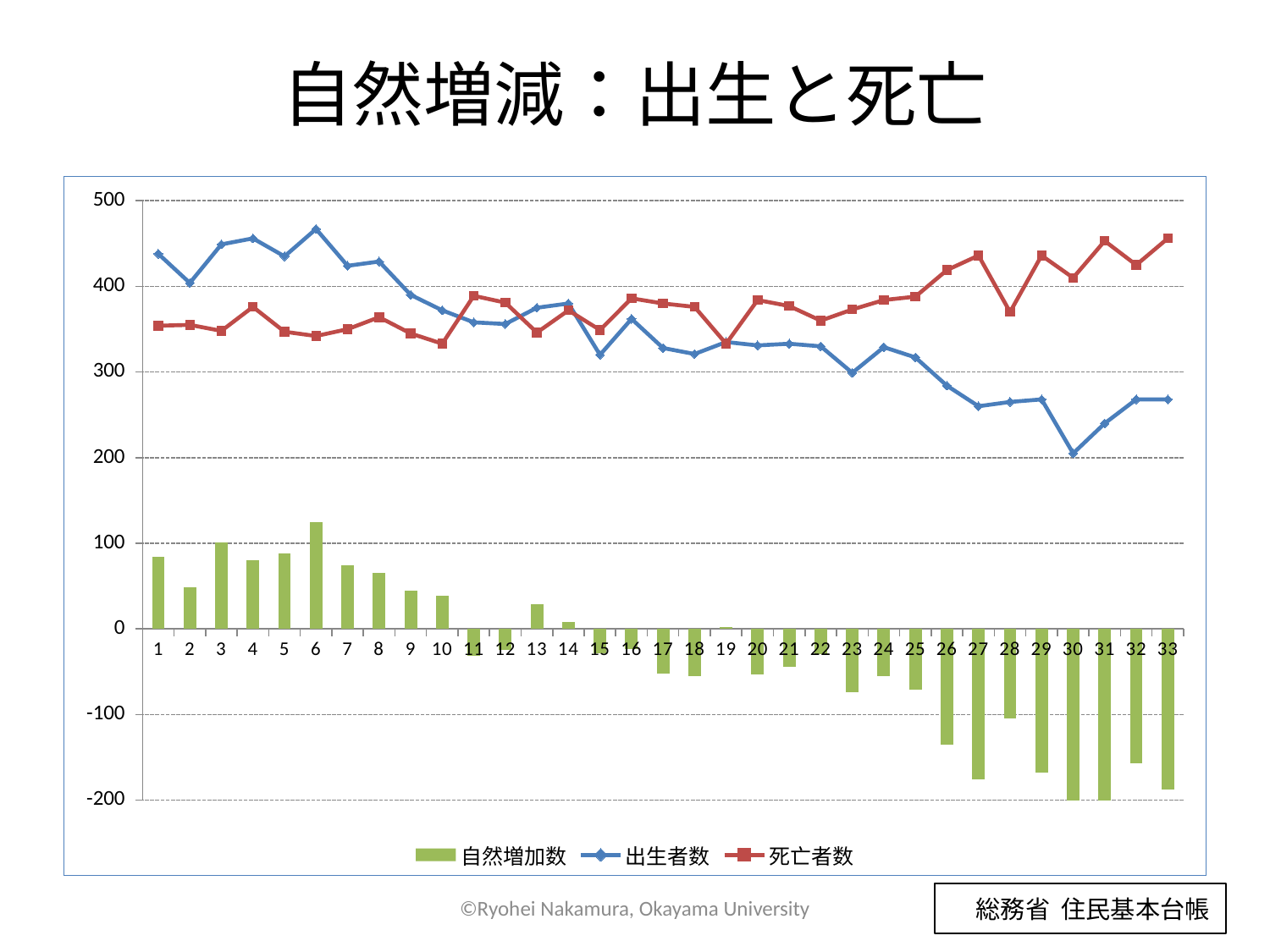
How many series does the legend list? 3 How many categories are shown on the x axis? 33 Is the value of 出生者数 at category 1 greater or less than 400? greater Is the value of 自然増加数 at category 6 greater or less than 100? greater What kind of chart is this? Combined bar and line chart At category 1, which is larger, 出生者数 or 死亡者数? 出生者数 Is the value of 死亡者数 at category 27 greater or less than 400? greater Which category has the lowest value for 出生者数? 30 Does 出生者数 generally rise or fall from category 1 to category 33? fall At category 33, which is larger, 出生者数 or 死亡者数? 死亡者数 Which category has the highest value for 自然増加数? 6